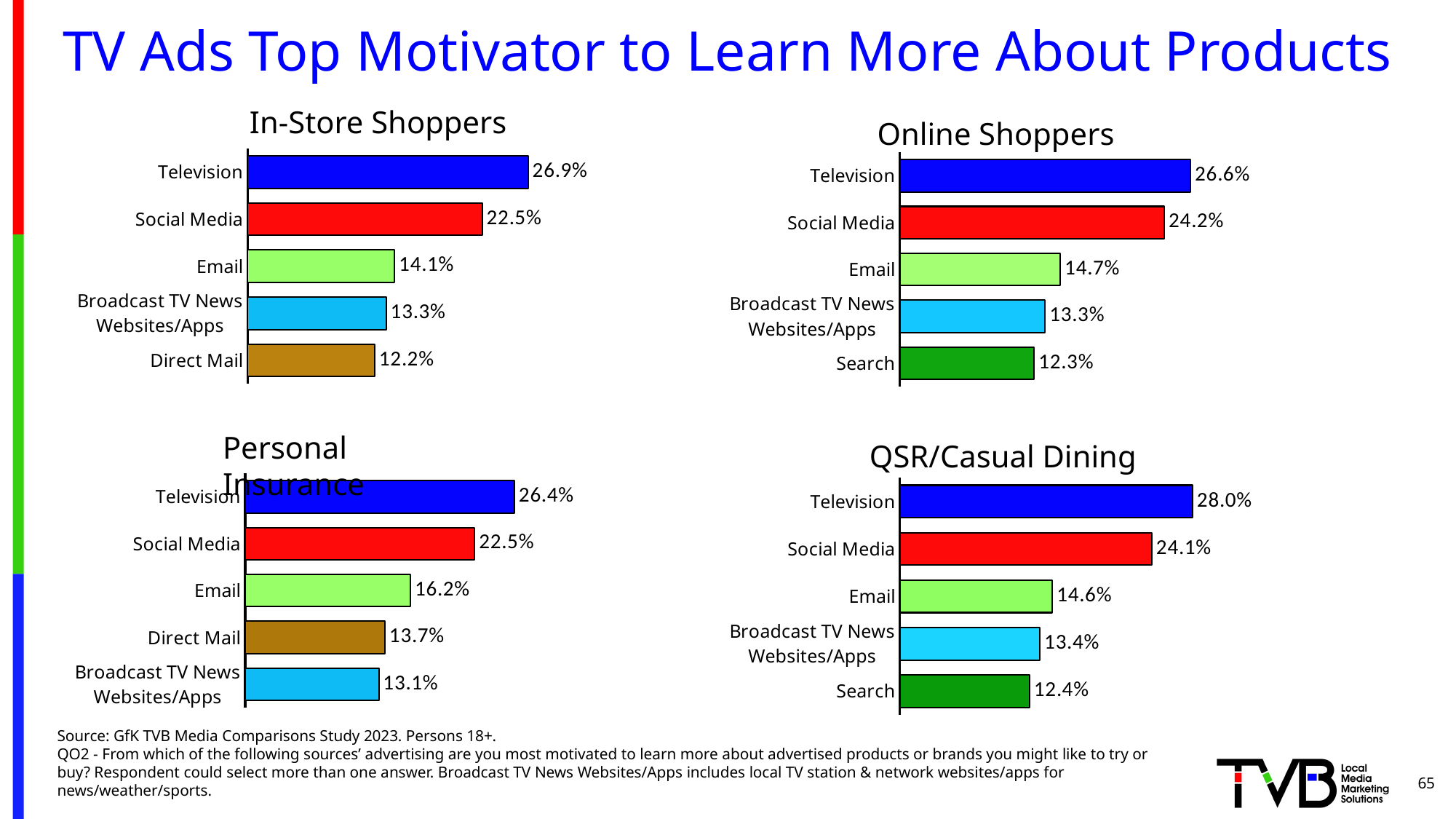
In the In-Store Shoppers chart, which category has the lowest value? Direct Mail In the QSR/Casual Dining chart, what is the value for Search? 12.4% How many categories are shown in the Online Shoppers chart? 5 What type of chart is the In-Store Shoppers chart? Bar chart In the Personal Insurance chart, what is the value for Email? 16.2% In the Online Shoppers chart, what is the difference between Television and Social Media? 2.4% How many charts are shown on the slide? 4 In the Personal Insurance chart, which is larger: Direct Mail or Broadcast TV News Websites/Apps? Direct Mail In the QSR/Casual Dining chart, which category has the highest value? Television In the In-Store Shoppers chart, what is the value for Television? 26.9% In the Online Shoppers chart, what is the value for Social Media? 24.2% In the QSR/Casual Dining chart, what is the difference between Email and Broadcast TV News Websites/Apps? 1.2%